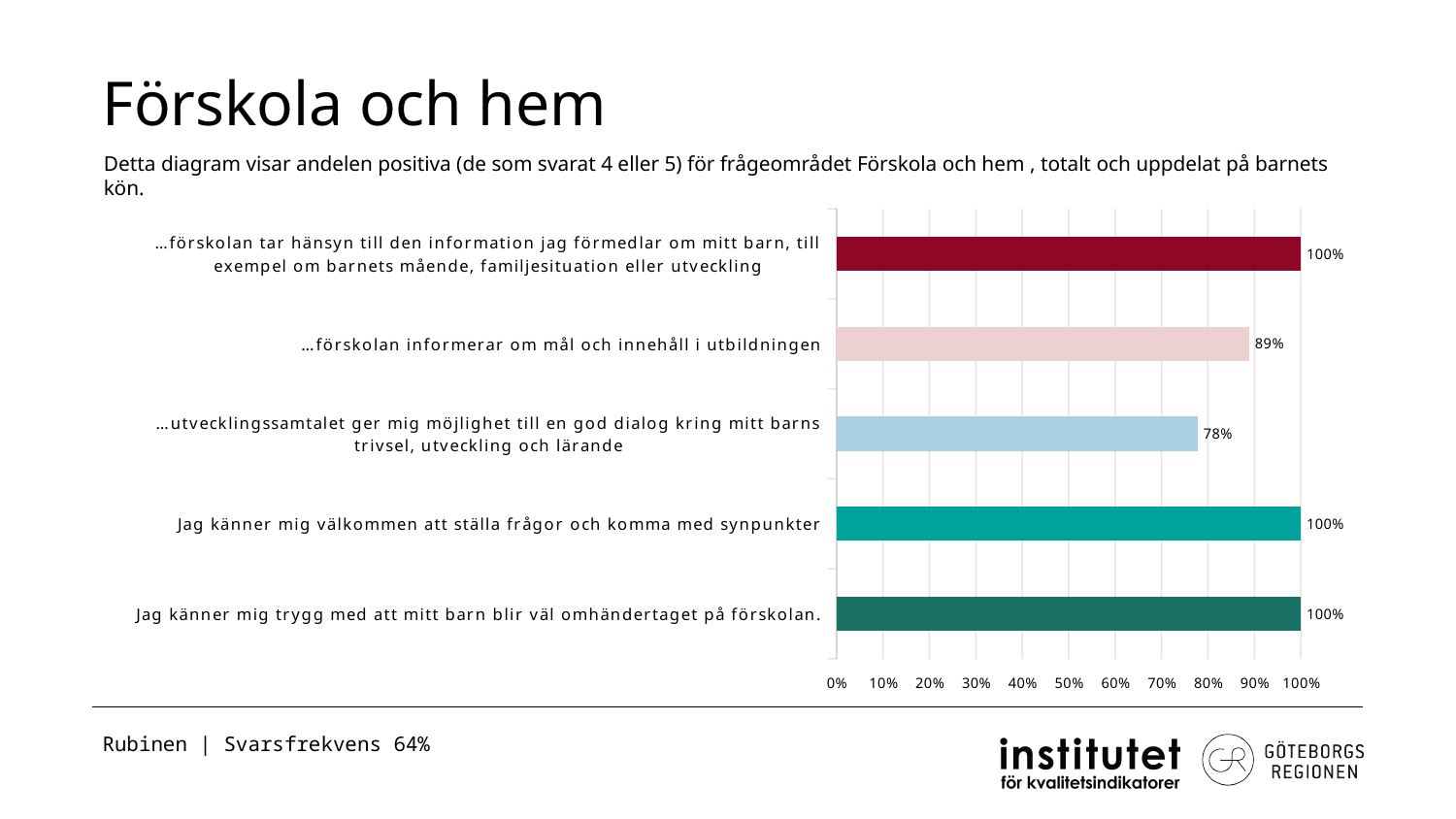
Which category has the lowest value? …utvecklingssamtalet ger mig möjlighet till en god dialog kring mitt barns trivsel, utveckling och lärande How many categories have a value of 100%? 3 What is the difference between the value for "…förskolan tar hänsyn till den information jag förmedlar om mitt barn, till exempel om barnets mående, familjesituation eller utveckling" and the value for "…förskolan informerar om mål och innehåll i utbildningen"? 11% What is the value for "…utvecklingssamtalet ger mig möjlighet till en god dialog kring mitt barns trivsel, utveckling och lärande"? 78% Is the value for "…utvecklingssamtalet ger mig möjlighet till en god dialog kring mitt barns trivsel, utveckling och lärande" greater or less than 80%? less What is the value for "…förskolan informerar om mål och innehåll i utbildningen"? 89% What is the value for "Jag känner mig välkommen att ställa frågor och komma med synpunkter"? 100% What kind of chart is shown on the slide? Bar chart How many categories are shown in the chart? 5 What is the difference between the value for "…förskolan informerar om mål och innehåll i utbildningen" and the value for "…utvecklingssamtalet ger mig möjlighet till en god dialog kring mitt barns trivsel, utveckling och lärande"? 11% Which is larger: the value for "…förskolan informerar om mål och innehåll i utbildningen" or the value for "…utvecklingssamtalet ger mig möjlighet till en god dialog kring mitt barns trivsel, utveckling och lärande"? …förskolan informerar om mål och innehåll i utbildningen What is the value for "Jag känner mig trygg med att mitt barn blir väl omhändertaget på förskolan."? 100%